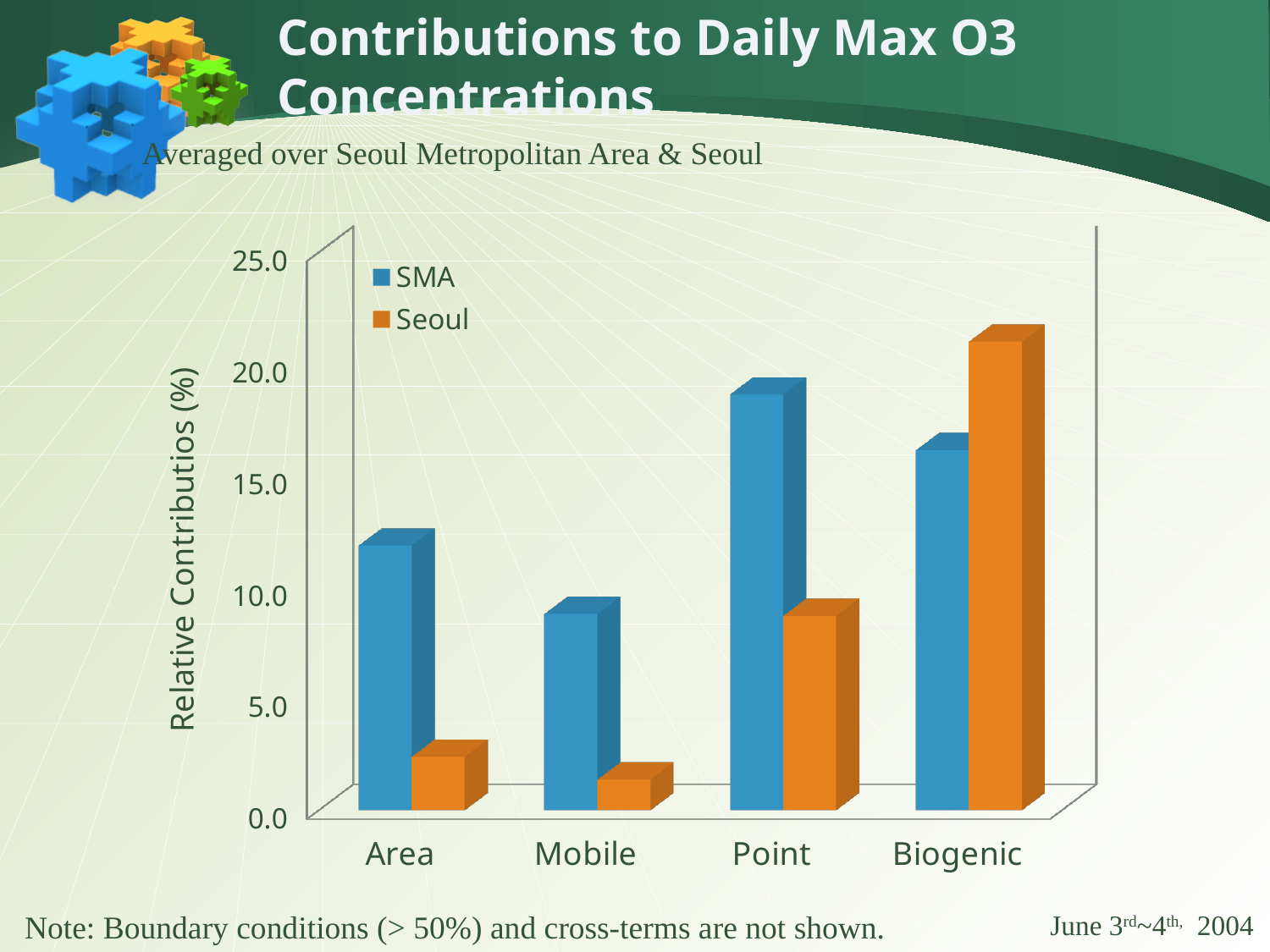
Which category has the lowest Seoul value? Mobile Is the SMA value for Area greater or less than 10.0? greater For Point, which series has the larger value, SMA or Seoul? SMA Which category has the highest SMA value? Point Which category has the highest Seoul value? Biogenic What is the title of the chart's vertical axis? Relative Contributions (%) How many categories are shown on the x axis of the chart? 4 What kind of chart is shown on the slide? bar chart For Biogenic, which series has the larger value, SMA or Seoul? Seoul How many series does the chart's legend list? 2 Which category has the lowest SMA value? Mobile